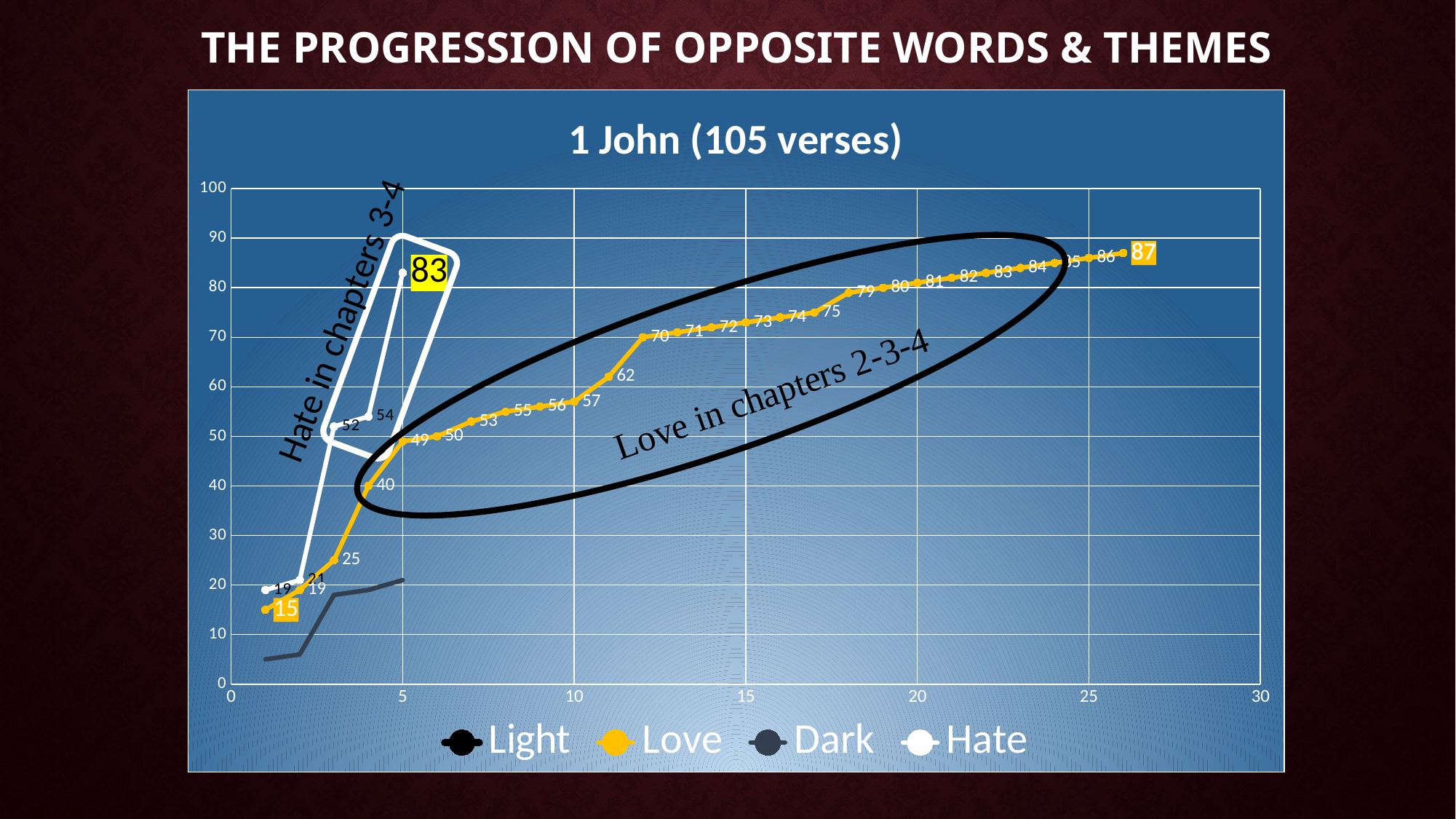
What kind of chart is shown on the slide? line chart What is the highest labelled value in the Love series? 87 What is the highest labelled value in the Hate series? 83 How many series does the legend list? 4 Which series is drawn in yellow/gold? Love What is the title of the chart? 1 John (105 verses) What is the difference between the highest and lowest labelled values of the Love series (87 and 15)? 72 What is the lowest labelled value in the Love series? 15 Which is larger: the highest labelled Love value or the highest labelled Hate value? Love (87) What is the lowest labelled value in the Hate series? 19 Do the Love series values rise or fall as the x axis increases? rise Is the highest point of the Dark series greater or less than 30? less